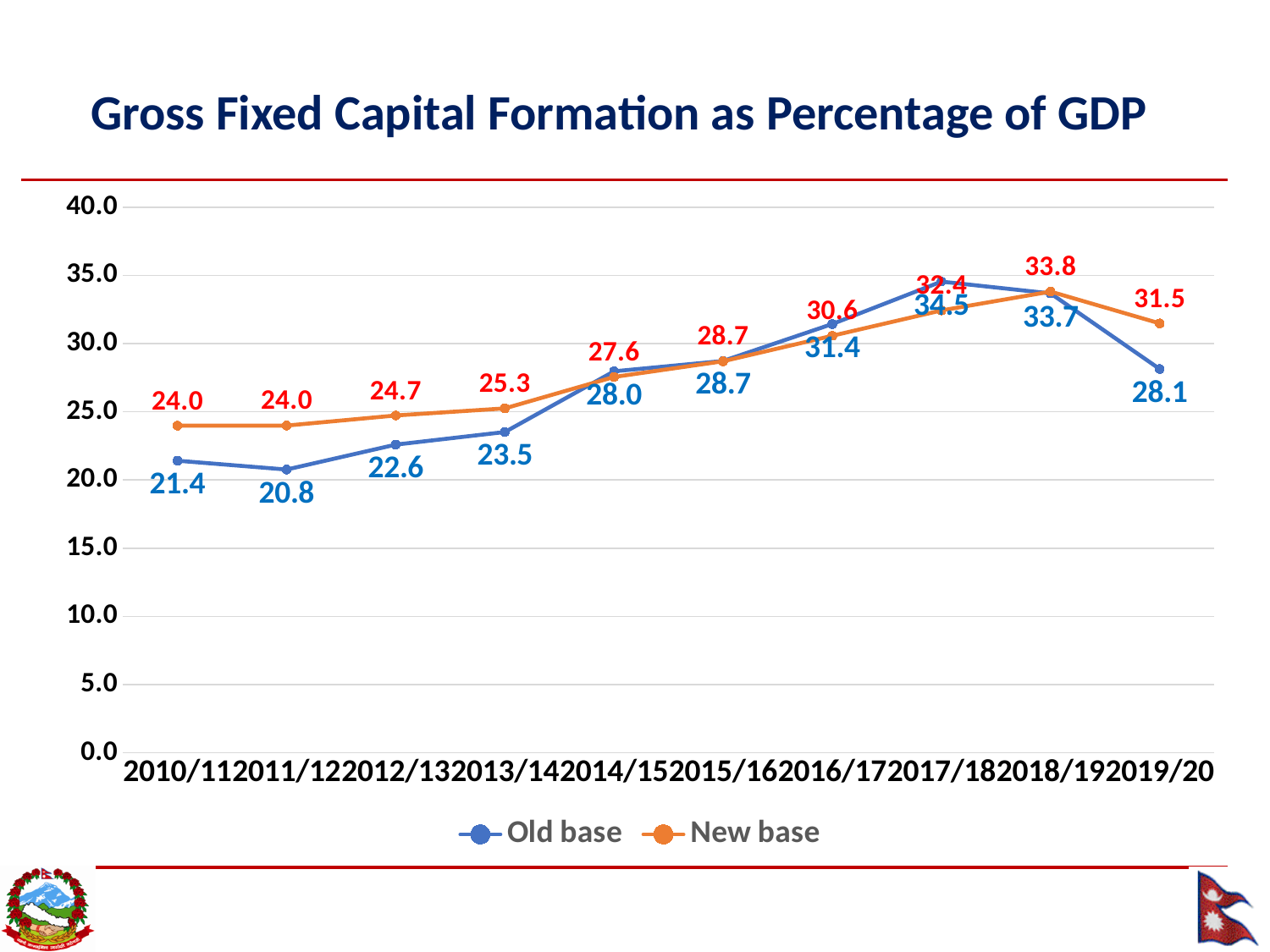
In which year does the Old base series reach its highest value? 2017/18 By how much does the Old base value fall from 2018/19 to 2019/20? 5.6 In which year does the New base series reach its highest value? 2018/19 What is the New base value for 2019/20? 31.5 How many fiscal years are plotted along the x axis? 10 What kind of chart is shown on the slide? Line chart Does the New base series rise or fall from 2010/11 to 2018/19? Rise In which year is the Old base value lowest? 2011/12 What are the two series named in the legend? Old base and New base In 2012/13, which series has the larger value, Old base or New base? New base What is the Old base value for 2010/11? 21.4 How many series does the legend list? 2